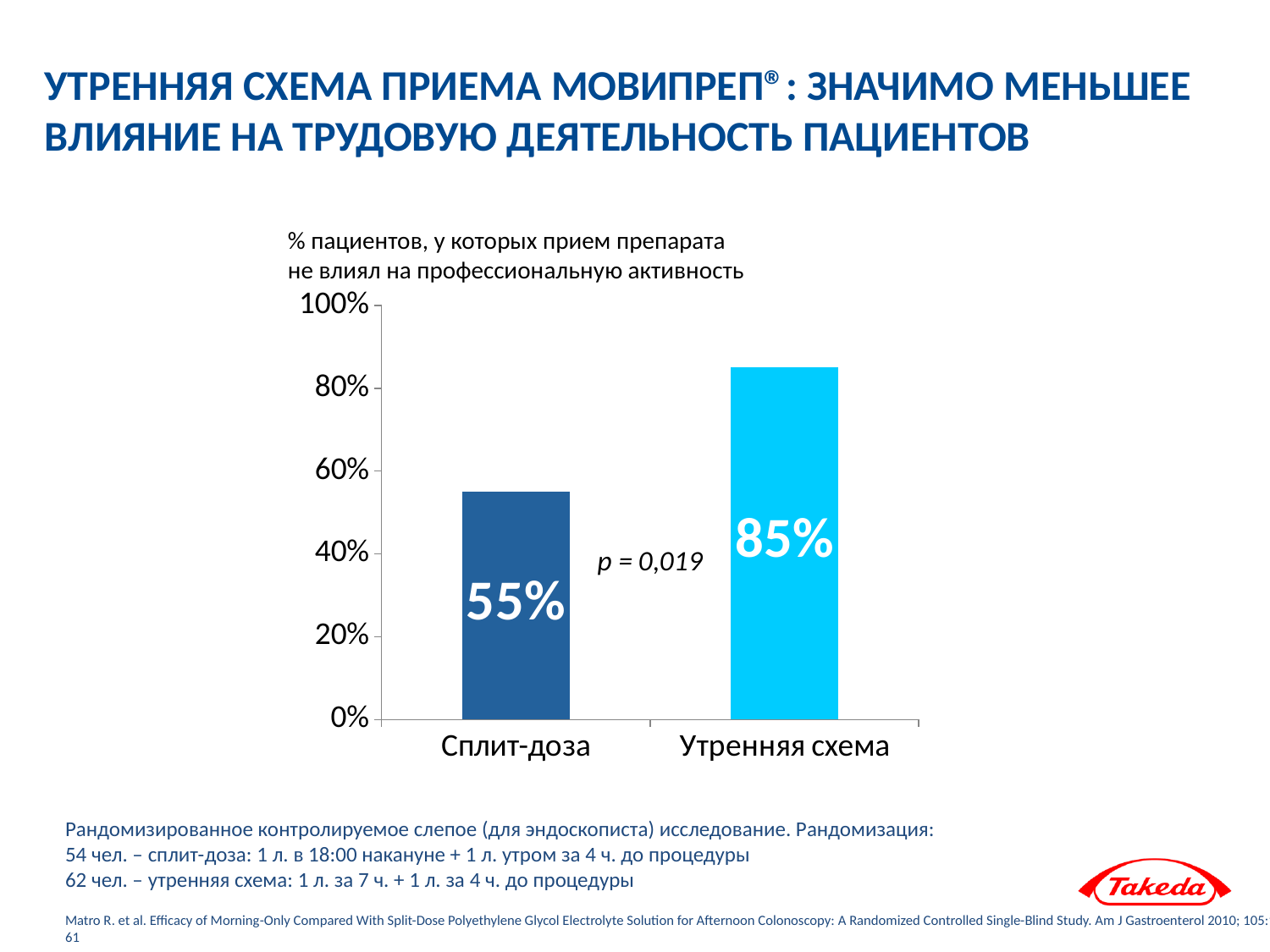
What p-value is printed on the chart? p = 0,019 Which is larger, the value for Сплит-доза or the value for Утренняя схема? Утренняя схема What is the highest value shown on the vertical axis of the chart? 100% What is the value for Утренняя схема? 85% What is the value for Сплит-доза? 55% Is the value for Утренняя схема greater or less than 80%? greater Which category has the highest value? Утренняя схема What kind of chart is shown on the slide? bar chart What is the difference between the values for Утренняя схема and Сплит-доза? 30% How many categories are shown on the chart? 2 Which category has the lowest value? Сплит-доза Is the value for Сплит-доза greater or less than 60%? less